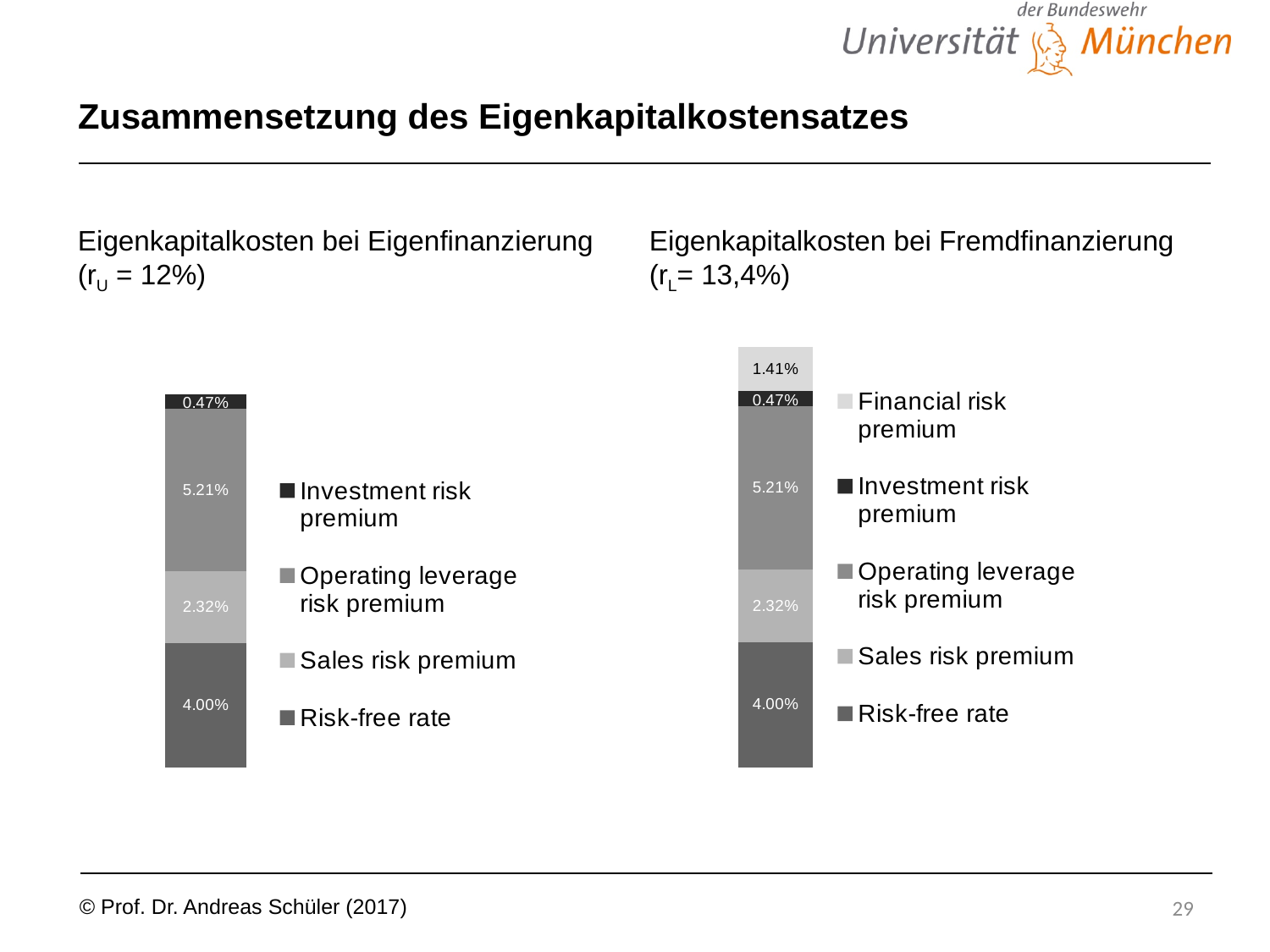
How many series does the legend of the left chart (Eigenkapitalkosten bei Eigenfinanzierung) list? 4 In the right chart (Eigenkapitalkosten bei Fremdfinanzierung), which segment has the largest value? Operating leverage risk premium In the right chart (Eigenkapitalkosten bei Fremdfinanzierung), what is the value of the Financial risk premium segment? 1.41% In the right chart (Eigenkapitalkosten bei Fremdfinanzierung), which is larger: the Financial risk premium or the Investment risk premium? Financial risk premium In the left chart (Eigenkapitalkosten bei Eigenfinanzierung), what is the value of the Operating leverage risk premium segment? 5.21% In the left chart (Eigenkapitalkosten bei Eigenfinanzierung), what is the value of the Risk-free rate segment? 4.00% What kind of chart is shown on the left (Eigenkapitalkosten bei Eigenfinanzierung)? Stacked bar chart In the right chart (Eigenkapitalkosten bei Fremdfinanzierung), what is the value of the Sales risk premium segment? 2.32% In the left chart (Eigenkapitalkosten bei Eigenfinanzierung), which segment has the smallest value? Investment risk premium How many series does the legend of the right chart (Eigenkapitalkosten bei Fremdfinanzierung) list? 5 What is the total of the stacked bar in the left chart (Eigenkapitalkosten bei Eigenfinanzierung)? 12.00% In the left chart (Eigenkapitalkosten bei Eigenfinanzierung), what is the difference between the Operating leverage risk premium and the Sales risk premium? 2.89%